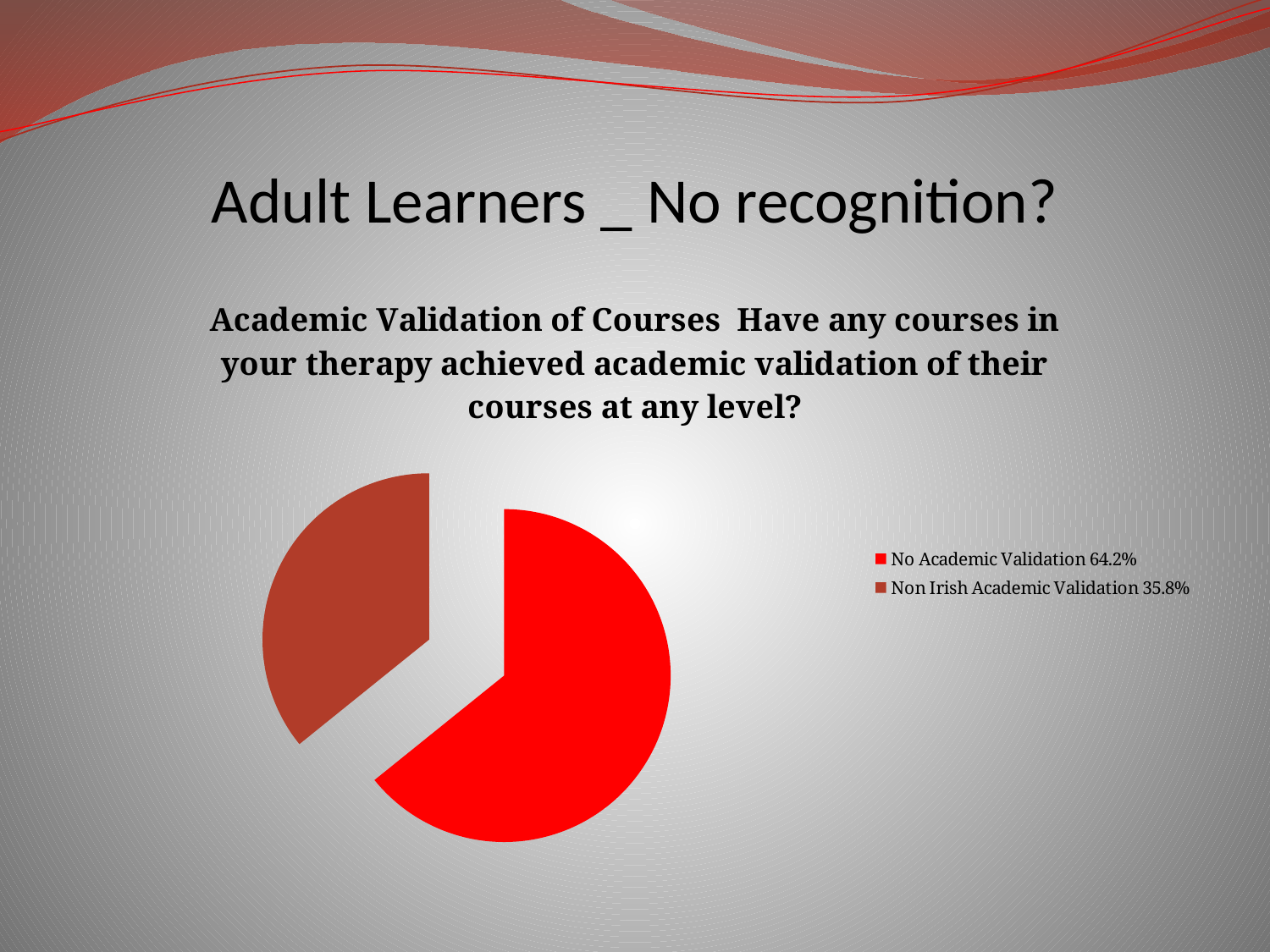
How many entries does the legend list? 2 What is the title of the chart? Academic Validation of Courses Have any courses in your therapy achieved academic validation of their courses at any level? Which is larger: the share for No Academic Validation or the share for Non Irish Academic Validation? No Academic Validation What share of the pie is labelled "Non Irish Academic Validation"? 35.8% What kind of chart is shown on the slide? pie chart What is the difference in percentage points between the No Academic Validation share and the Non Irish Academic Validation share? 28.4 Which slice is shown in bright red? No Academic Validation 64.2% What share of the pie is labelled "No Academic Validation"? 64.2% Which slice of the pie chart is the largest? No Academic Validation How many slices does the pie chart have? 2 Which slice of the pie chart is the smallest? Non Irish Academic Validation